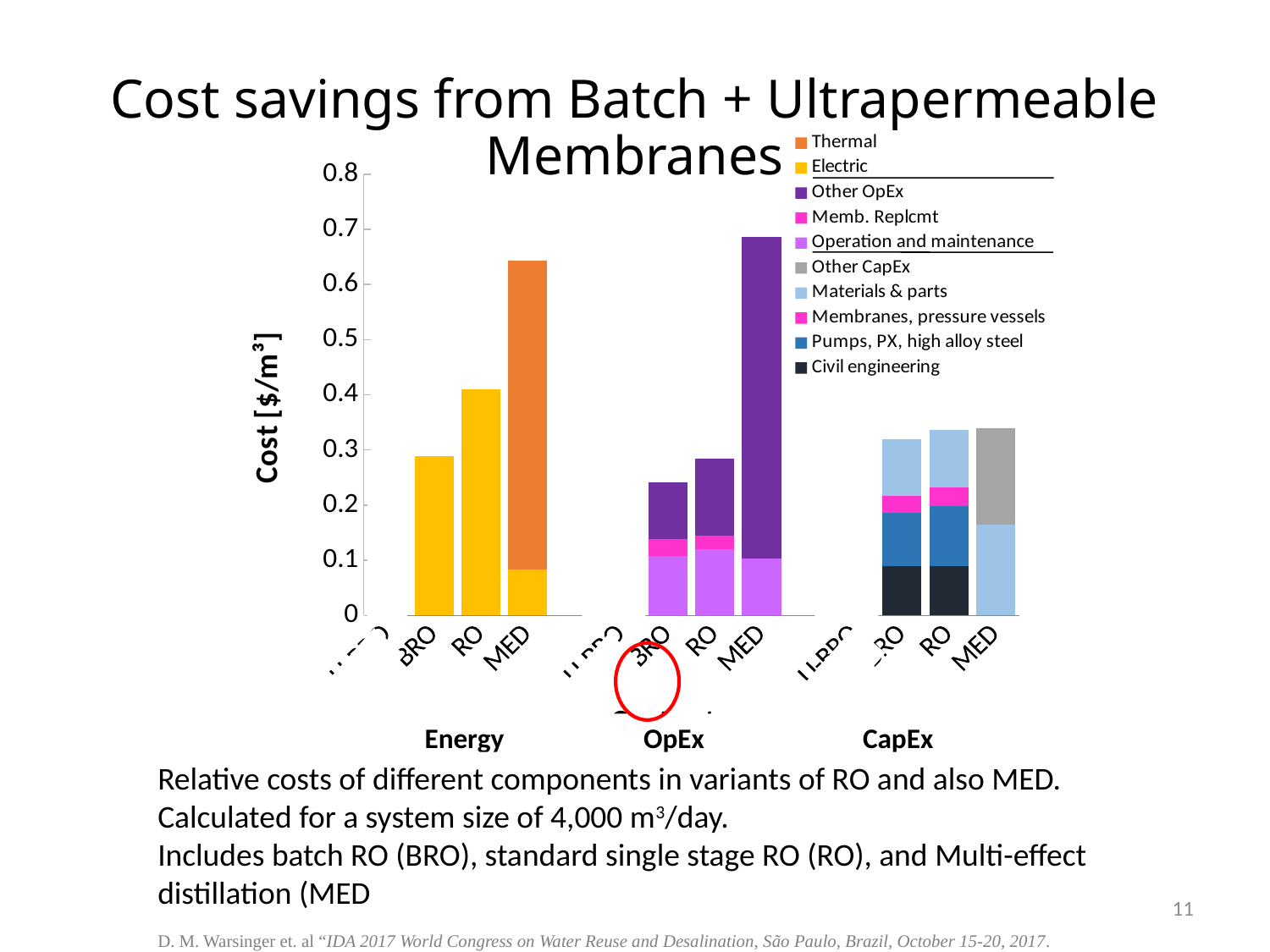
In the OpEx group, which category has the highest total cost? MED Is the total CapEx cost for MED greater or less than 0.3? greater Is the total OpEx cost for BRO greater or less than 0.3? less What is the label on the vertical axis? Cost [$/m³] Is the total Energy cost for MED greater or less than 0.6? greater Within the Energy group, do the total costs rise or fall going from BRO to RO to MED? rise Which is larger, the total OpEx cost for MED or the total OpEx cost for RO? MED In the Energy group, which category has the lowest total cost? BRO In the Energy group, which category has the highest total cost? MED How many cost groups are labelled along the bottom of the chart? 3 How many series does the legend list? 10 What kind of chart is shown on the slide? stacked bar chart